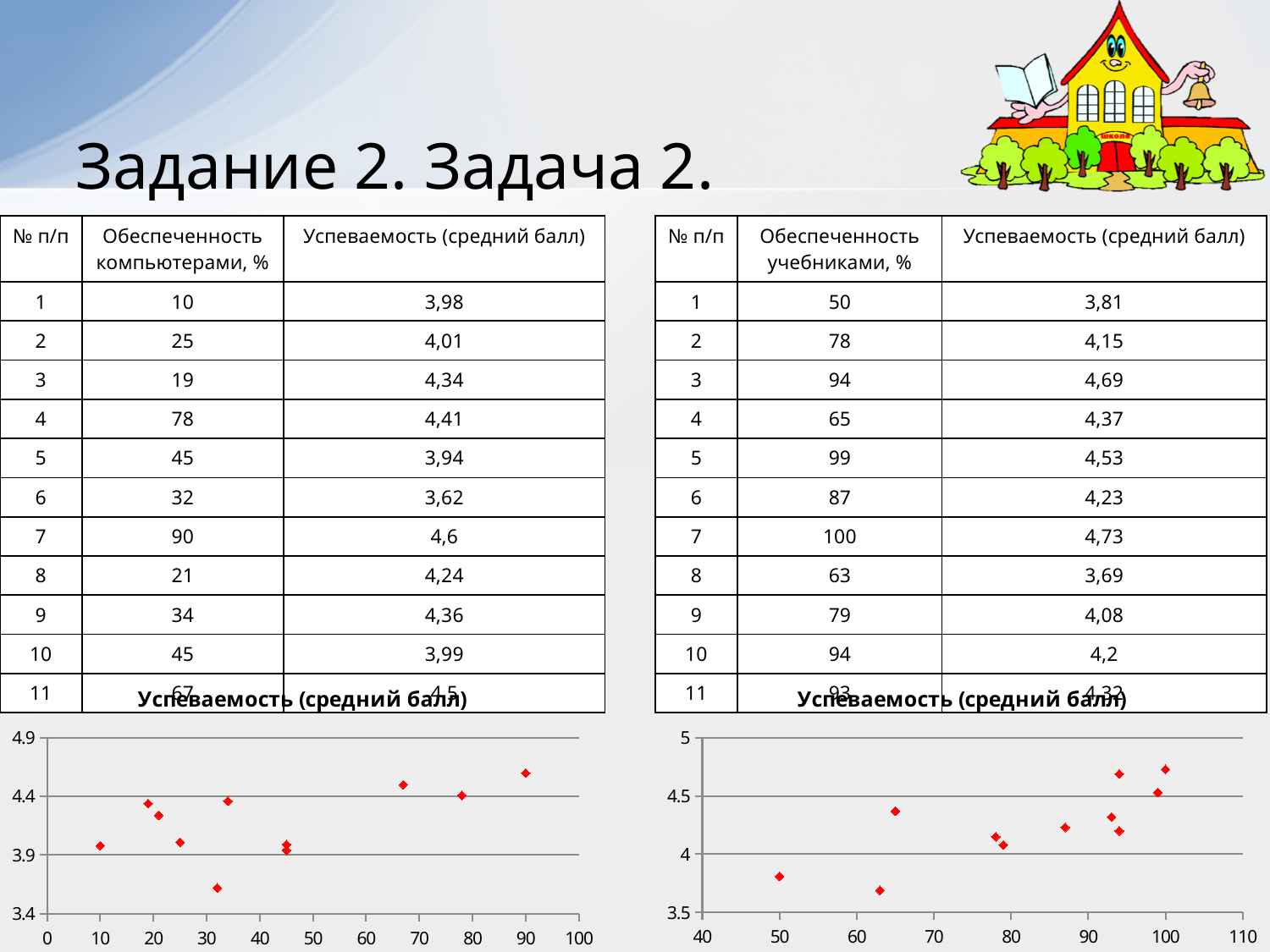
What is the title of the right chart on the slide? Успеваемость (средний балл) How many data points are plotted on the left chart? 11 On the left chart, is the value of the point at x = 90 greater or less than 4.4? greater On the left chart, is the value of the point at x = 32 greater or less than 3.9? less What is the highest tick shown on the x axis of the right chart? 110 On the right chart, is the value of the point at x = 50 greater or less than 4? less What kind of chart is the left chart on the slide? scatter chart How many data points are plotted on the right chart? 11 On the left chart, at which x value is the lowest point plotted? 32 On the right chart, do the plotted values generally rise or fall as x increases? rise On the right chart, at which x value is the lowest point plotted? 63